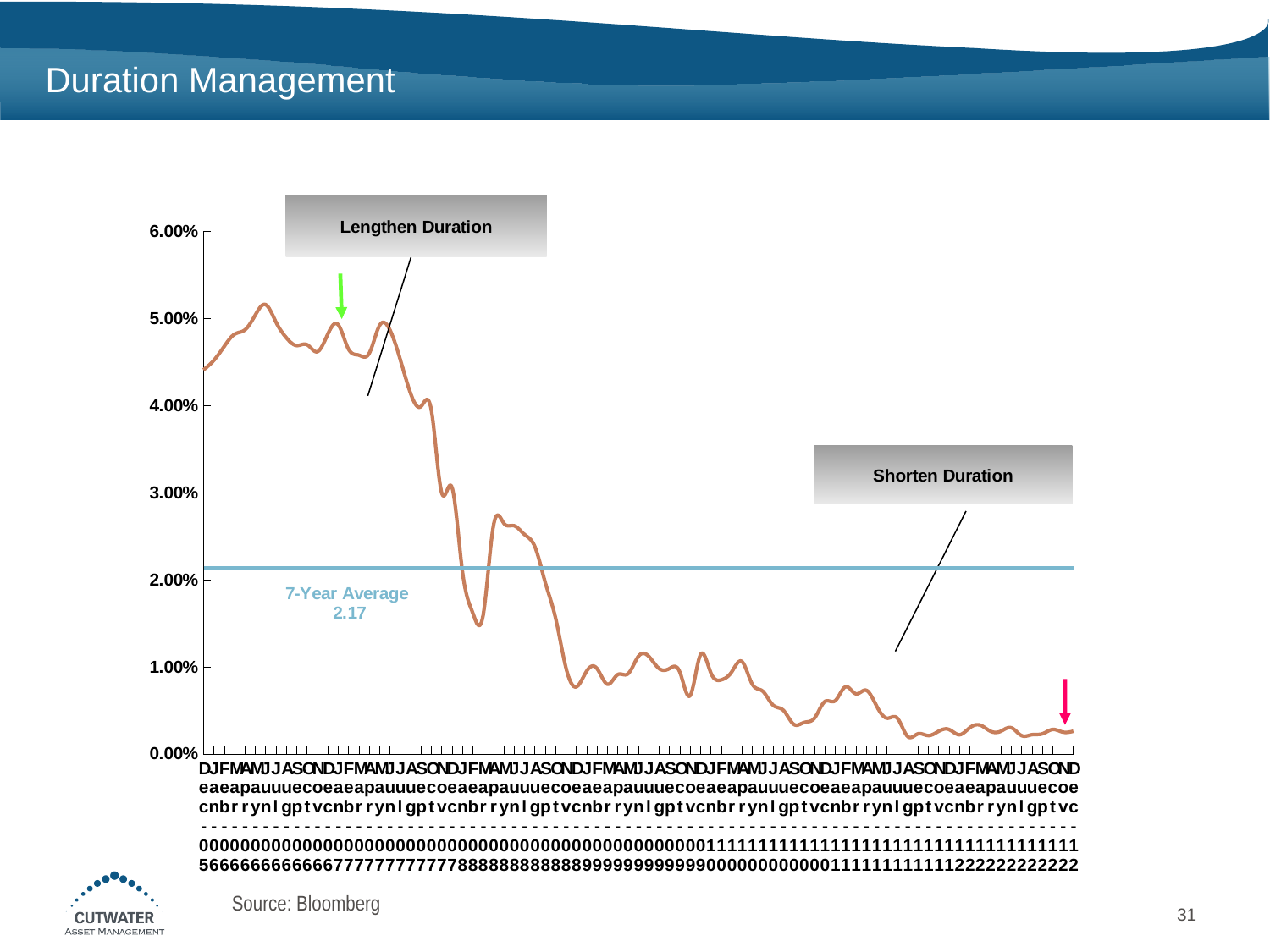
Is the value at the far left start of the line (the first point) greater or less than 4.00%? greater Is the value at the far right end of the line (the last point) greater or less than 1.00%? less What is the highest value shown on the y axis? 6.00% Is the highest point of the line greater or less than 5.00%? greater Which is larger: the value at the start of the line or the value at the end of the line? the value at the start What is the value of the 7-Year Average shown on the chart? 2.17 What are the two annotation labels shown on the chart? Lengthen Duration and Shorten Duration What kind of chart is shown on the slide? line chart Do the plotted values generally rise or fall from left to right along the x axis? fall